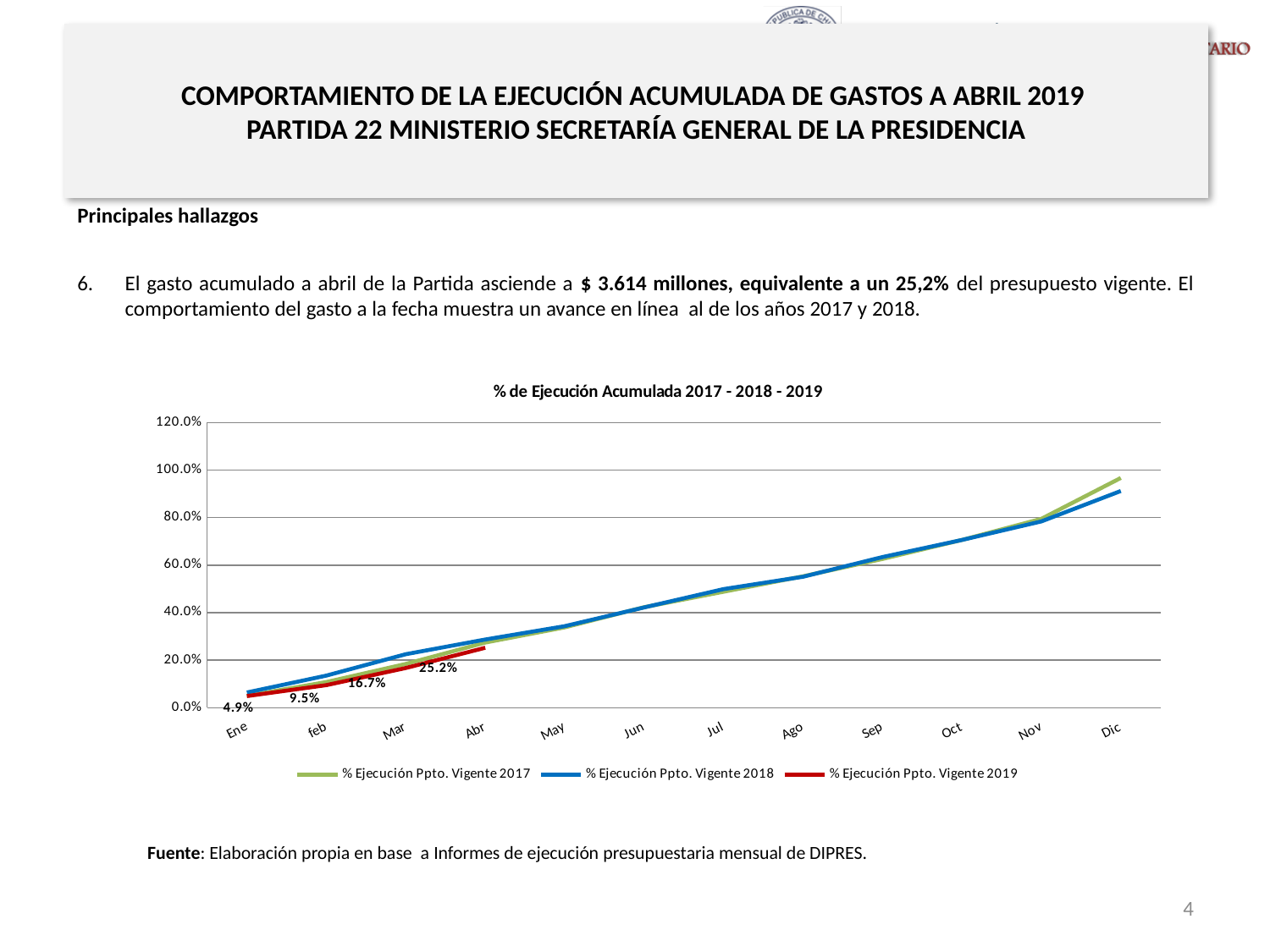
What kind of chart is shown on the slide? line chart What is the value for % Ejecución Ppto. Vigente 2019 in Mar? 16.7% How many series does the legend list? 3 Do the values for % Ejecución Ppto. Vigente 2018 rise or fall from Ene to Dic? rise What is the difference between the 2019 values for Feb and Ene? 4.6% In Dic, which series has the higher value: % Ejecución Ppto. Vigente 2017 or % Ejecución Ppto. Vigente 2018? % Ejecución Ppto. Vigente 2017 Is the value for % Ejecución Ppto. Vigente 2018 in Dic greater or less than 80.0%? greater What is the title of the chart? % de Ejecución Acumulada 2017 - 2018 - 2019 What is the value for % Ejecución Ppto. Vigente 2019 in Abr? 25.2% What is the difference between the 2019 values for Abr and Mar? 8.5% What is the value for % Ejecución Ppto. Vigente 2019 in Ene? 4.9% How many months are shown along the x axis? 12